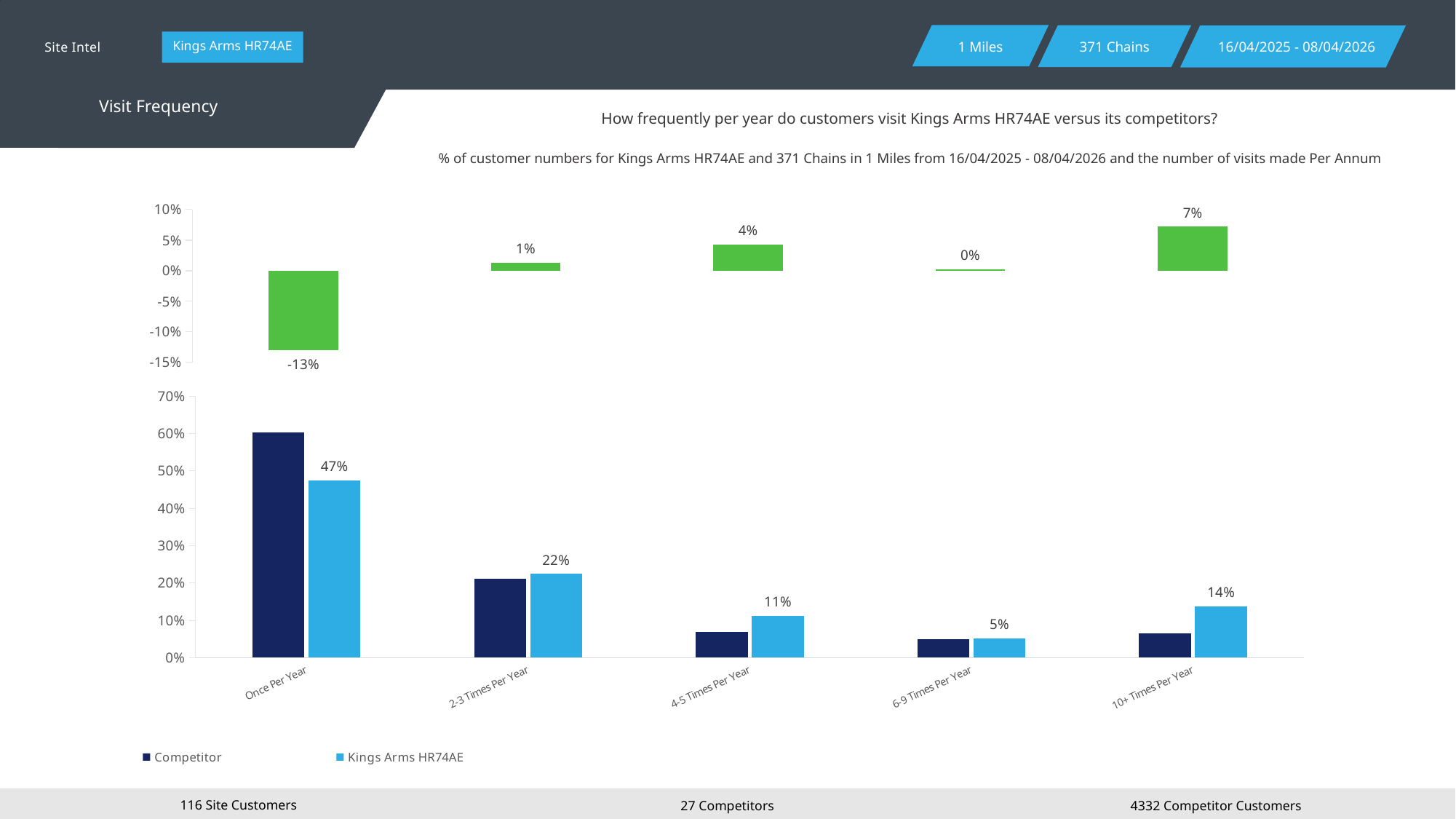
In the bottom chart, is the Competitor value for Once Per Year greater or less than 50%? greater In the top chart, which category has the lowest value? Once Per Year How many series does the legend of the bottom chart list? 2 In the bottom chart, what is the value for Kings Arms HR74AE in the Once Per Year category? 47% In the top chart, what is the value shown for Once Per Year? -13% In the bottom chart, is the Competitor value for 4-5 Times Per Year greater or less than 10%? less In the bottom chart, what is the value for Kings Arms HR74AE in the 10+ Times Per Year category? 14% In the bottom chart, what is the difference between the Kings Arms HR74AE values for Once Per Year and 2-3 Times Per Year? 25% In the top chart, which category has the highest value? 10+ Times Per Year In the bottom chart, for Once Per Year, which is larger: the Competitor value or the Kings Arms HR74AE value? Competitor How many visit frequency categories are shown on the x axis of the bottom chart? 5 What kind of chart is the bottom chart? bar chart